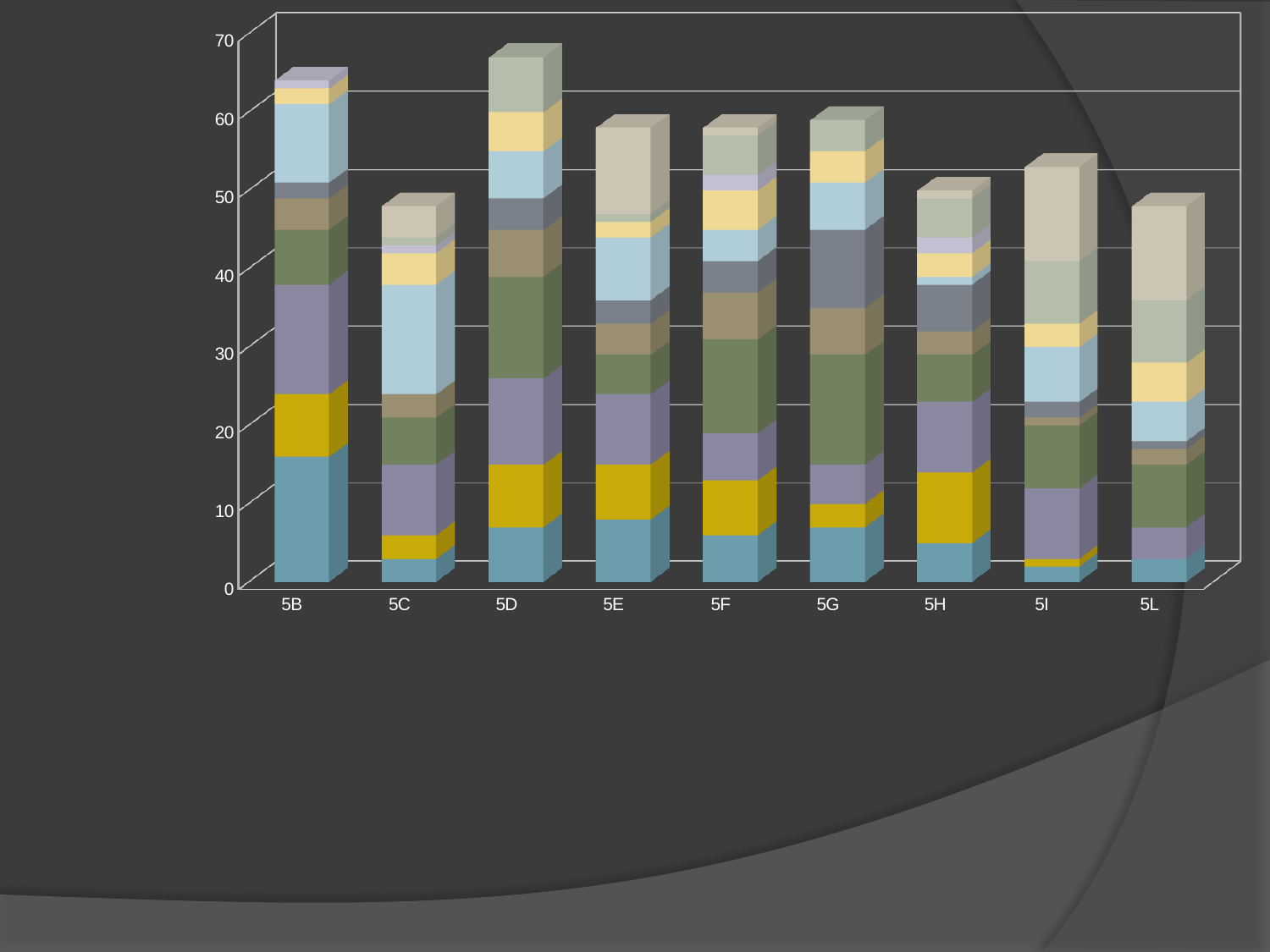
Is the total for 5H greater or less than 60? less How many categories are shown along the x axis? 9 Is the total for 5B greater or less than 60? greater Is the total for 5D greater or less than 60? greater Which category has the tallest stacked bar? 5D What is the label of the first category on the x axis? 5B What kind of chart is shown on the slide? stacked bar chart What is the highest value shown on the vertical axis? 70 Which has the taller stacked bar, 5D or 5C? 5D Which has the taller stacked bar, 5B or 5H? 5B